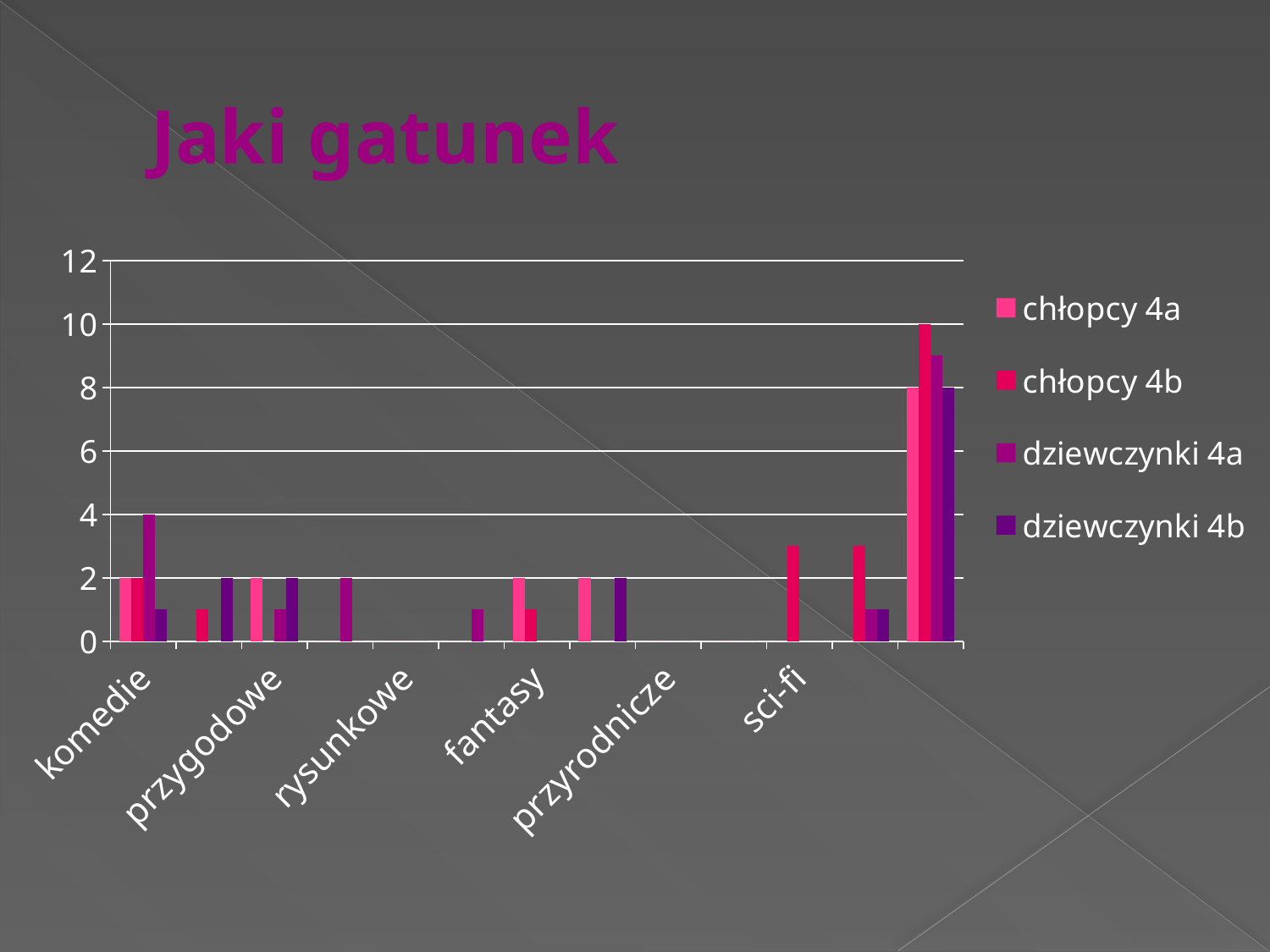
What kind of chart is shown on the slide? bar chart What is the value for chłopcy 4a in the komedie category? 2 Which series are listed in the legend? chłopcy 4a, chłopcy 4b, dziewczynki 4a, dziewczynki 4b Is the value for dziewczynki 4b in the komedie category greater or less than 2? less Is the value for chłopcy 4b in the sci-fi category greater or less than 2? greater In the komedie category, which is larger: dziewczynki 4a or chłopcy 4b? dziewczynki 4a What is the value for dziewczynki 4a in the komedie category? 4 Which series has the highest value in the komedie category? dziewczynki 4a What is the value for chłopcy 4a in the przygodowe category? 2 In the komedie category, what is the difference between dziewczynki 4a and chłopcy 4a? 2 What is the title of the chart? Jaki gatunek How many series does the legend list? 4